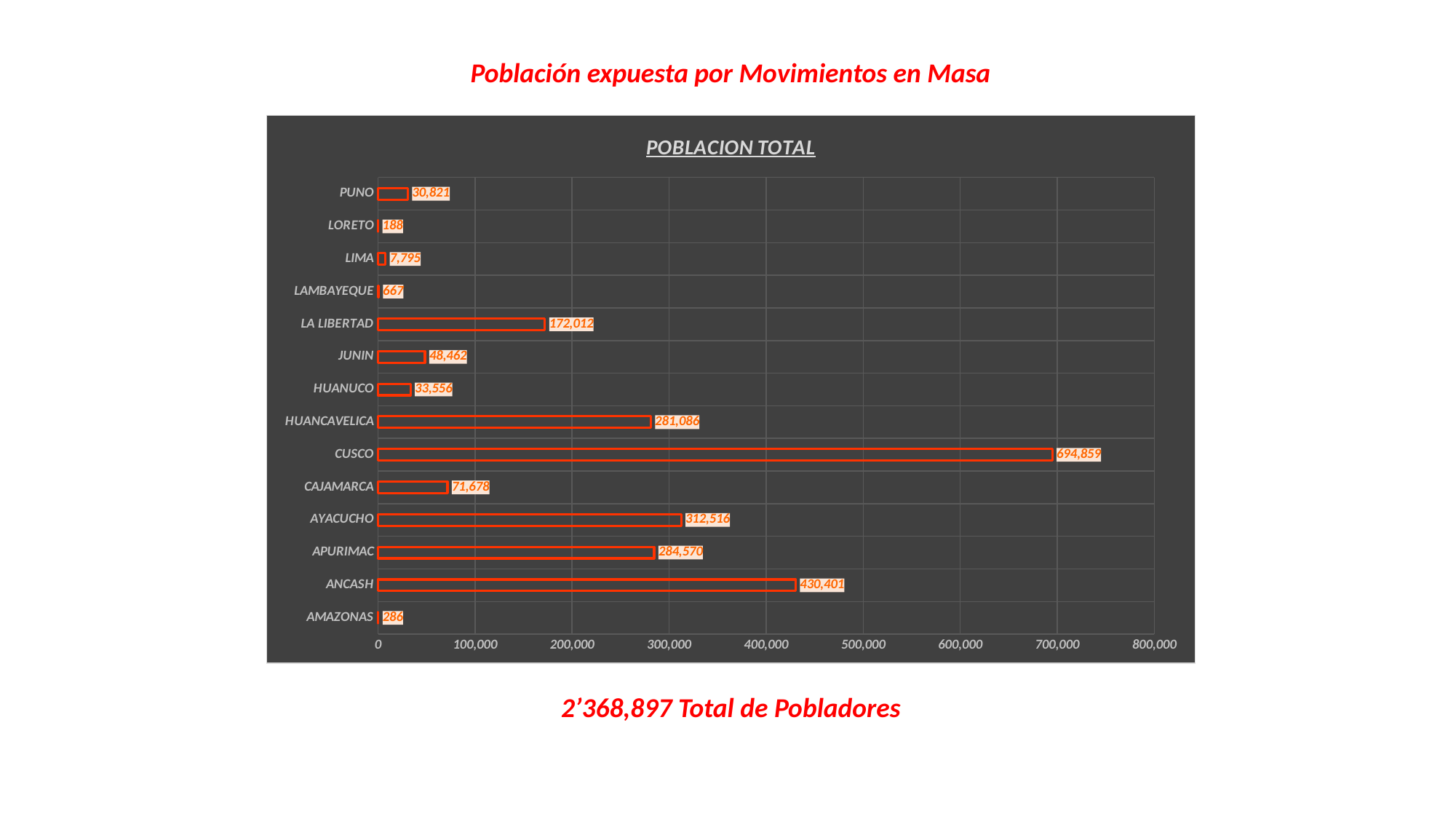
What is the title of the chart? POBLACION TOTAL What is the value for LORETO? 188 What is the difference between the values for AYACUCHO and APURIMAC? 27,946 What is the value for LA LIBERTAD? 172,012 What is the difference between the values for CUSCO and ANCASH? 264,458 How many categories are shown in the chart? 14 What is the value for CUSCO? 694,859 Which category has the highest value? CUSCO Which is larger, the value for ANCASH or the value for AYACUCHO? ANCASH What kind of chart is shown on the slide? bar chart Which category has the lowest value? LORETO Is the value for LA LIBERTAD greater or less than 200,000? less